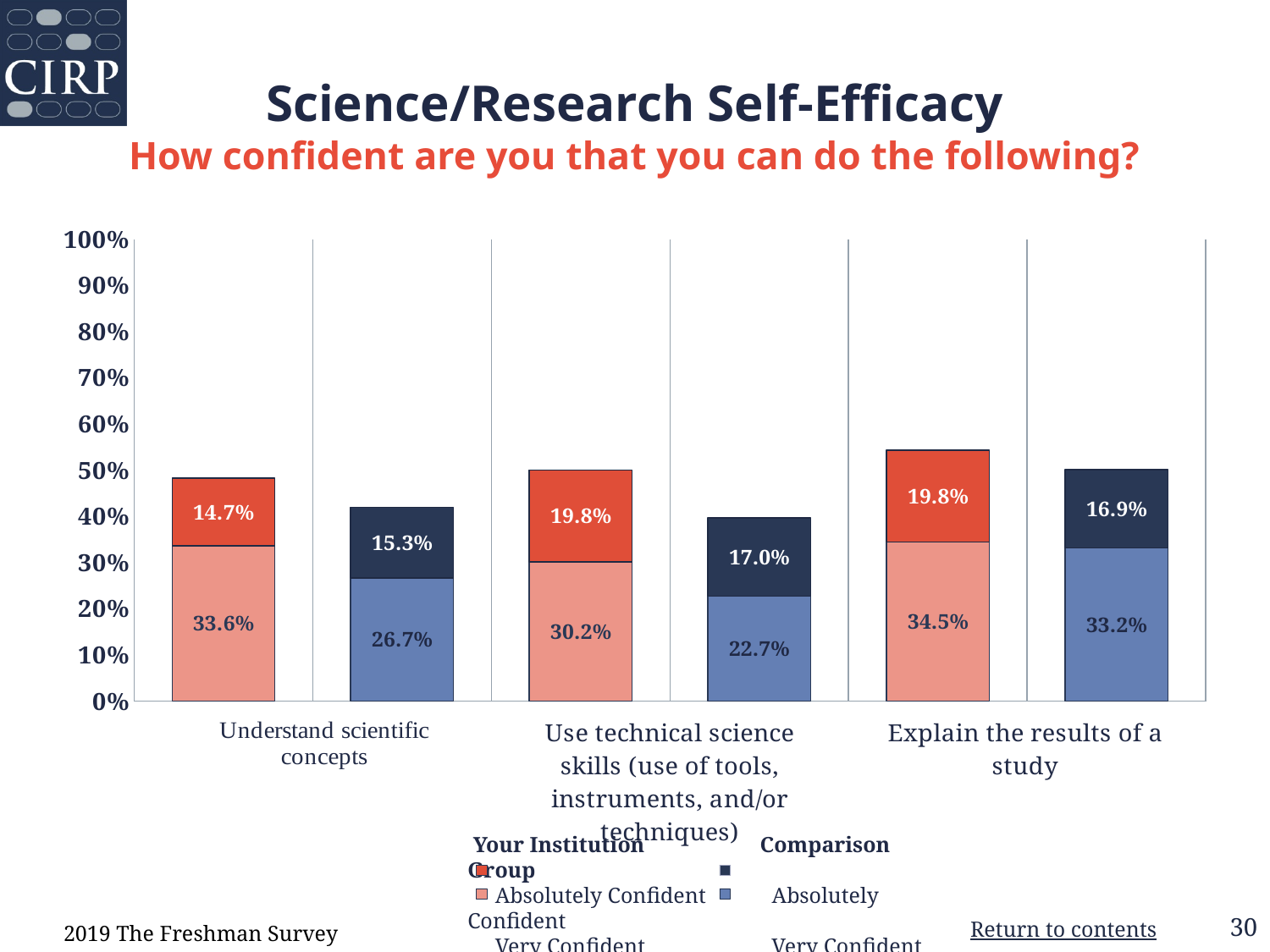
Is the total of the Comparison Group bar for 'Use technical science skills' greater or less than 50%? less What is the difference between the bottom segments of the Your Institution and Comparison Group bars for 'Understand scientific concepts' (33.6% vs 26.7%)? 6.9% What is the total of the Comparison Group stacked bar for 'Understand scientific concepts'? 42.0% What is the value of the bottom segment of the Comparison Group bar for 'Explain the results of a study'? 33.2% What is the value of the top segment of the Comparison Group bar for 'Use technical science skills (use of tools, instruments, and/or techniques)'? 17.0% What is the subtitle question shown in orange above the chart? How confident are you that you can do the following? What is the total of the Your Institution stacked bar for 'Explain the results of a study'? 54.3% Which is larger: the top segment of the Your Institution bar (19.8%) or the top segment of the Comparison Group bar (17.0%) for 'Use technical science skills'? Your Institution (19.8%) Which category has the tallest Your Institution stacked bar? Explain the results of a study How many categories are shown along the x axis? 3 What is the value of the bottom segment of the Your Institution bar for 'Understand scientific concepts'? 33.6% What type of chart is shown on the slide? stacked bar chart